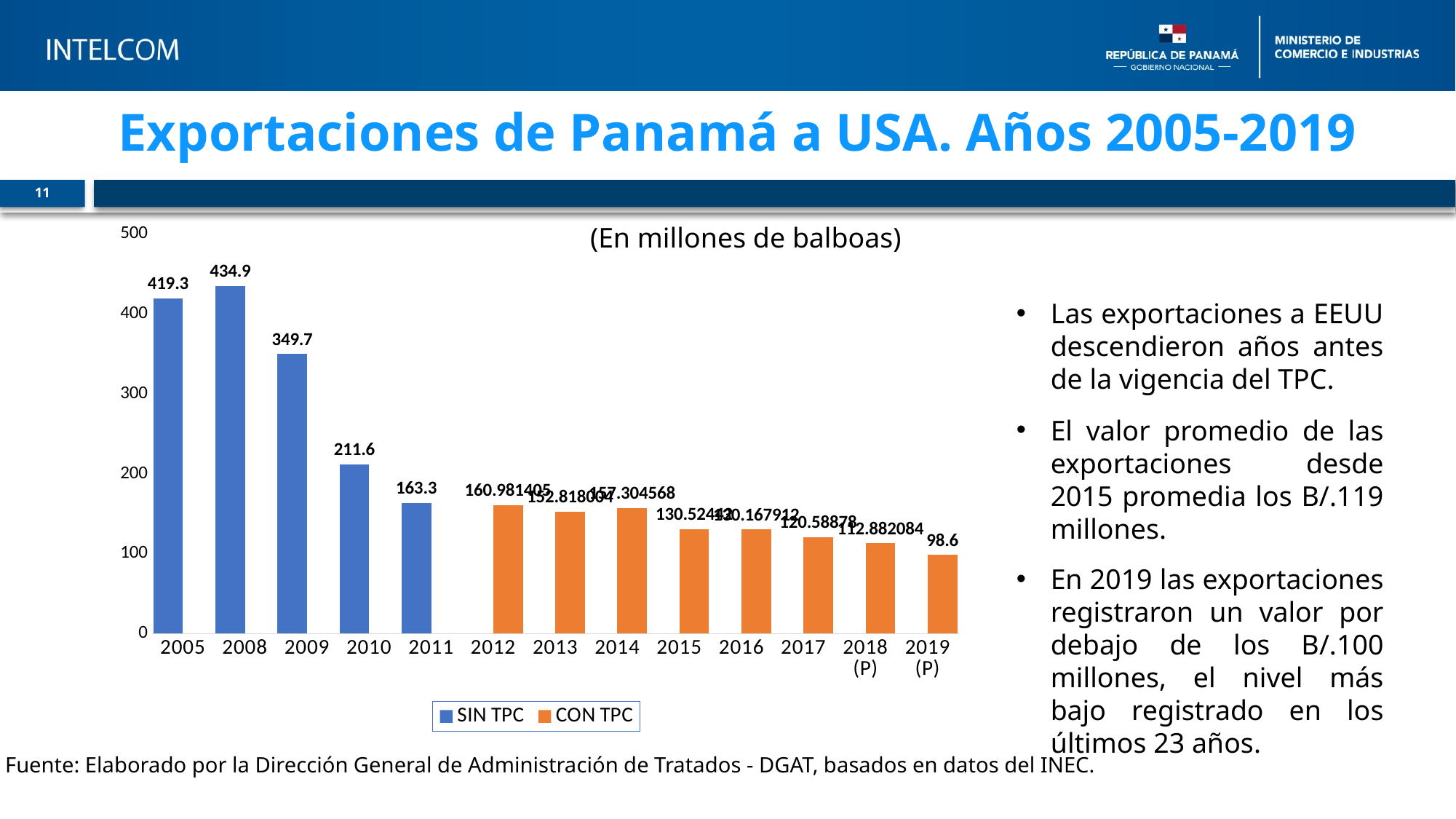
How many years are shown on the x axis? 13 Which year has the highest value? 2008 What is the value for 2019 (P)? 98.6 How many series does the legend list? 2 Which is larger, the value for 2009 or the value for 2010? 2009 Is the value for 2015 greater or less than 100? greater What kind of chart is this? bar chart Which year has the lowest value? 2019 (P) What is the value for 2011? 163.3 What is the difference between the values for 2008 and 2005? 15.6 What is the value for 2008? 434.9 Do the values generally rise or fall from 2008 to 2019? fall